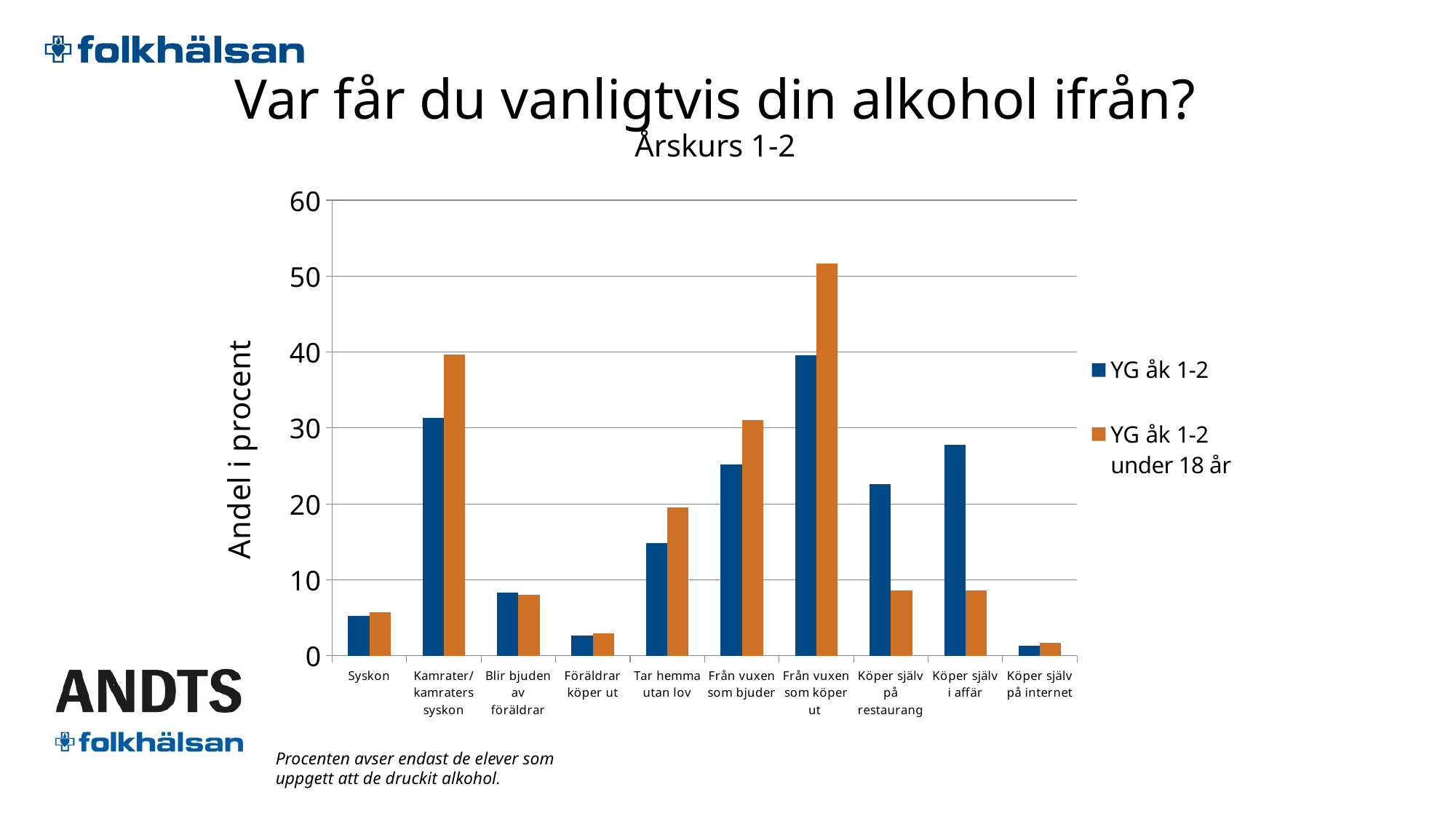
Is the value for 'Från vuxen som köper ut' in the series 'YG åk 1-2 under 18 år' greater or less than 50? greater Is the value for 'Köper själv i affär' in the series 'YG åk 1-2' greater or less than 30? less Which category has the lowest value for the series 'YG åk 1-2'? Köper själv på internet Which category has the highest value for the series 'YG åk 1-2'? Från vuxen som köper ut For 'Kamrater/kamraters syskon', which series has the larger value: 'YG åk 1-2' or 'YG åk 1-2 under 18 år'? YG åk 1-2 under 18 år Which category has the highest value for the series 'YG åk 1-2 under 18 år'? Från vuxen som köper ut What is the label of the y axis? Andel i procent Is the value for 'Köper själv på restaurang' in the series 'YG åk 1-2' greater or less than 20? greater What kind of chart is shown on the slide? bar chart For 'Köper själv i affär', which series has the larger value: 'YG åk 1-2' or 'YG åk 1-2 under 18 år'? YG åk 1-2 How many series does the legend list? 2 How many categories are shown on the x axis? 10